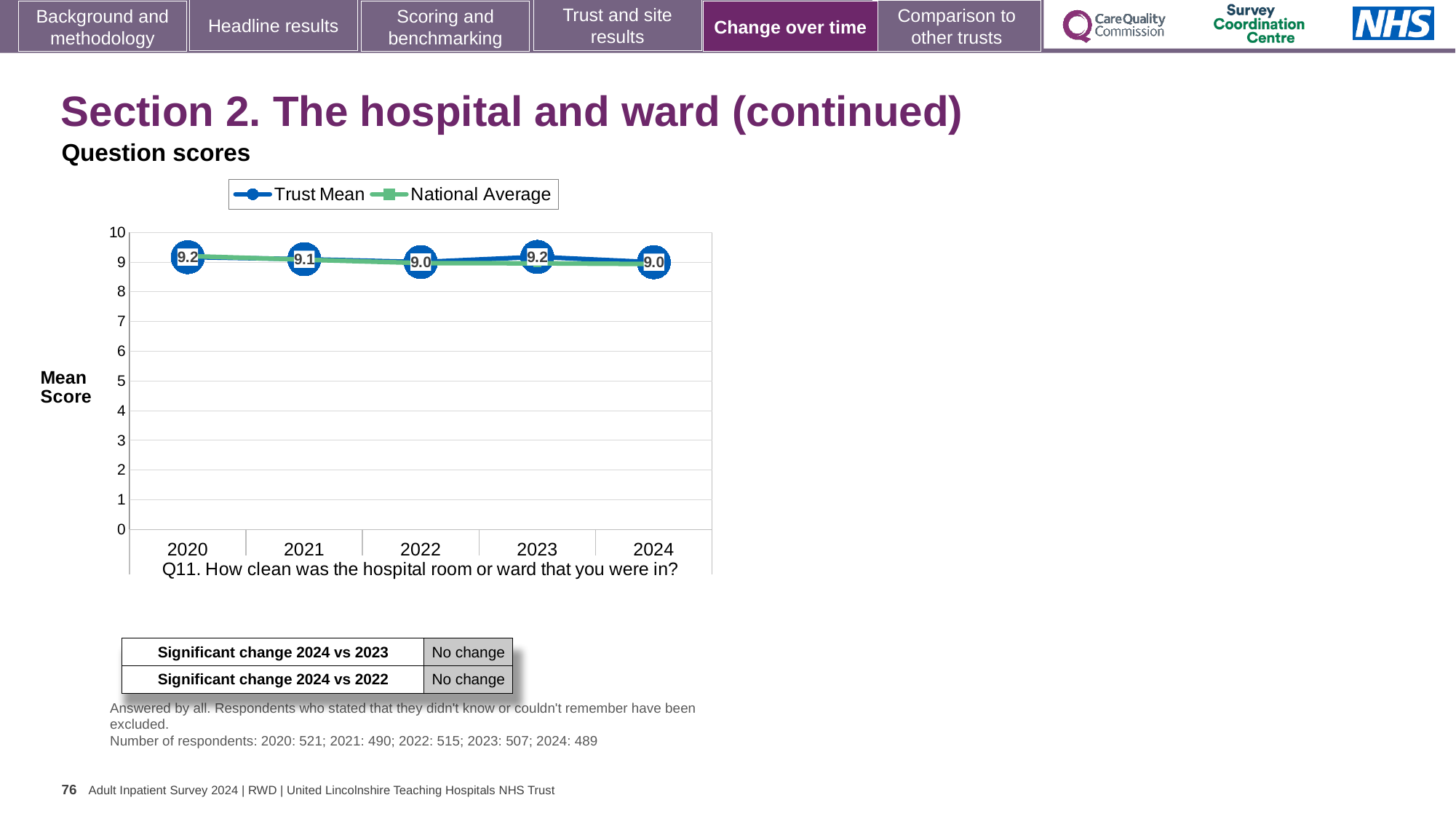
What is the Trust Mean value for 2023? 9.2 How many series does the chart legend list? 2 How many years are shown on the x axis of the chart? 5 What kind of chart is shown on the slide? Line chart Which year has the larger Trust Mean value, 2021 or 2022? 2021 What is the difference between the Trust Mean values for 2023 and 2024? 0.2 Is the National Average value for 2024 greater or less than 8? greater What is the Trust Mean value for 2021? 9.1 Does the Trust Mean rise or fall from 2023 to 2024? Fall What is the Trust Mean value for 2020? 9.2 What is the Trust Mean value for 2024? 9.0 What is the Trust Mean value for 2022? 9.0